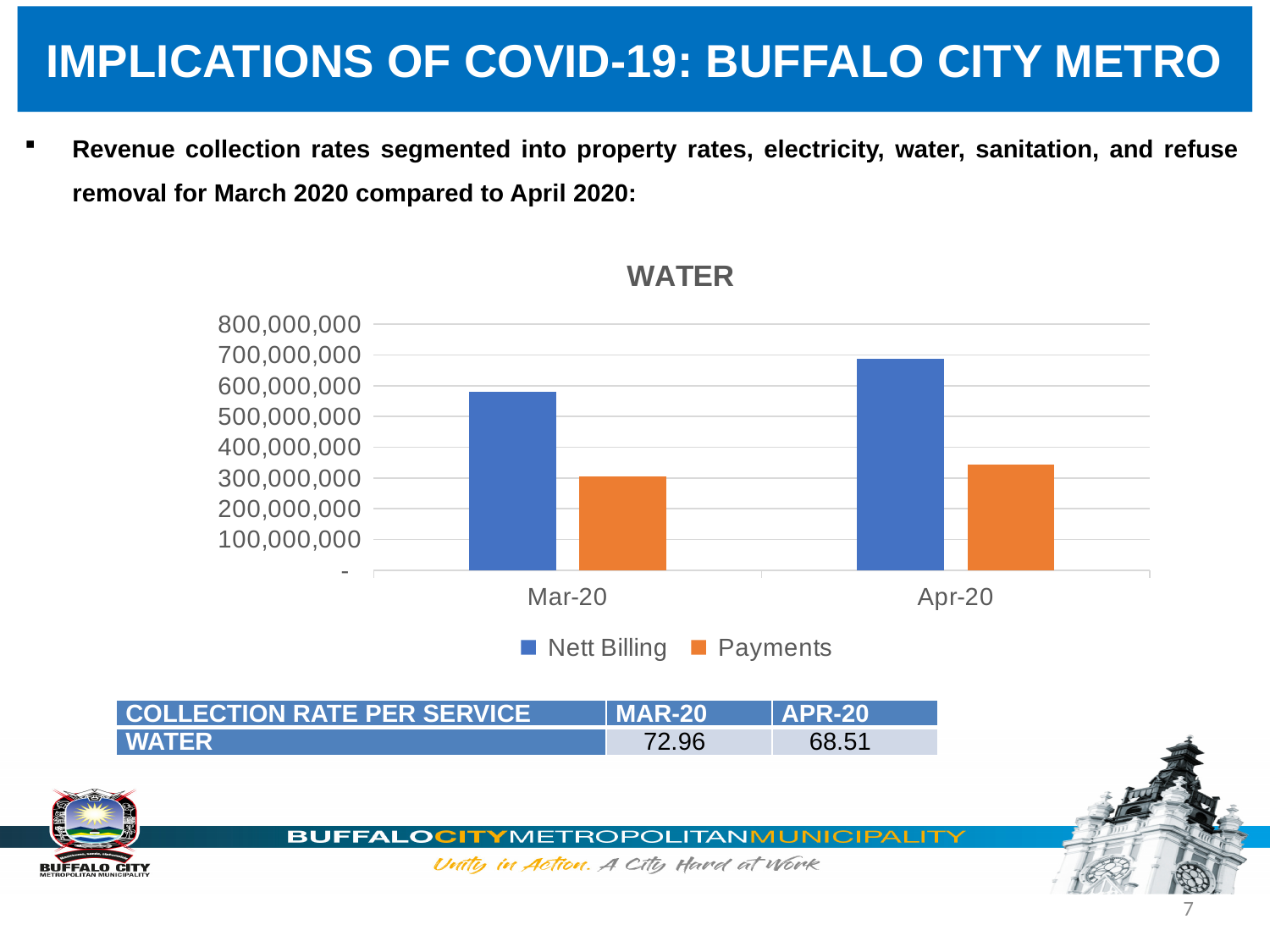
Does Nett Billing rise or fall from Mar-20 to Apr-20? rise Which series are listed in the chart's legend? Nett Billing and Payments What is the title of the chart? WATER What kind of chart is shown on the slide? bar chart Which month has the higher Nett Billing, Mar-20 or Apr-20? Apr-20 How many series does the chart's legend list? 2 Which bar in the chart is the tallest? Nett Billing for Apr-20 Is the Payments value for Apr-20 greater or less than 400,000,000? less Is the Nett Billing value for Apr-20 greater or less than 600,000,000? greater Is the Payments value for Mar-20 greater or less than 400,000,000? less How many categories are shown on the x axis of the chart? 2